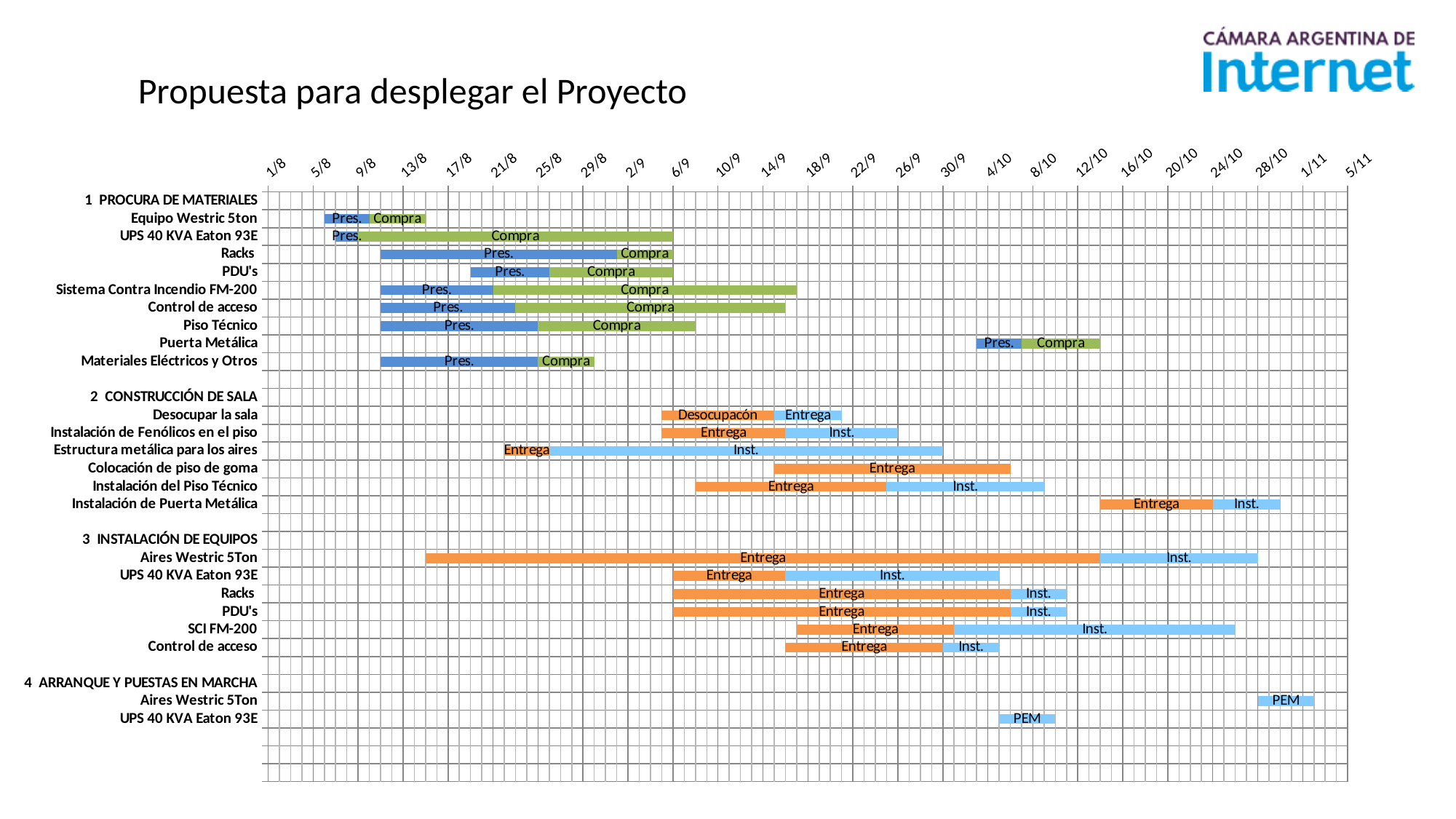
What is the last date shown on the chart's time axis? 5/11 In section 4, which task's PEM bar occurs later: Aires Westric 5Ton or UPS 40 KVA Eaton 93E? Aires Westric 5Ton Which task in section 2 CONSTRUCCIÓN DE SALA starts earliest on the timeline? Estructura metálica para los aires How many numbered sections (phases) does the chart list? 4 What is the title of the slide containing the chart? Propuesta para desplegar el Proyecto How many tasks are listed under section 4 ARRANQUE Y PUESTAS EN MARCHA? 2 What kind of chart is shown on the slide? Gantt chart What is the first date shown on the chart's time axis? 1/8 How many tasks are listed under section 2 CONSTRUCCIÓN DE SALA? 6 Which task in section 3 INSTALACIÓN DE EQUIPOS has the longest Entrega bar? Aires Westric 5Ton Which task in section 1 PROCURA DE MATERIALES starts latest on the timeline? Puerta Metálica